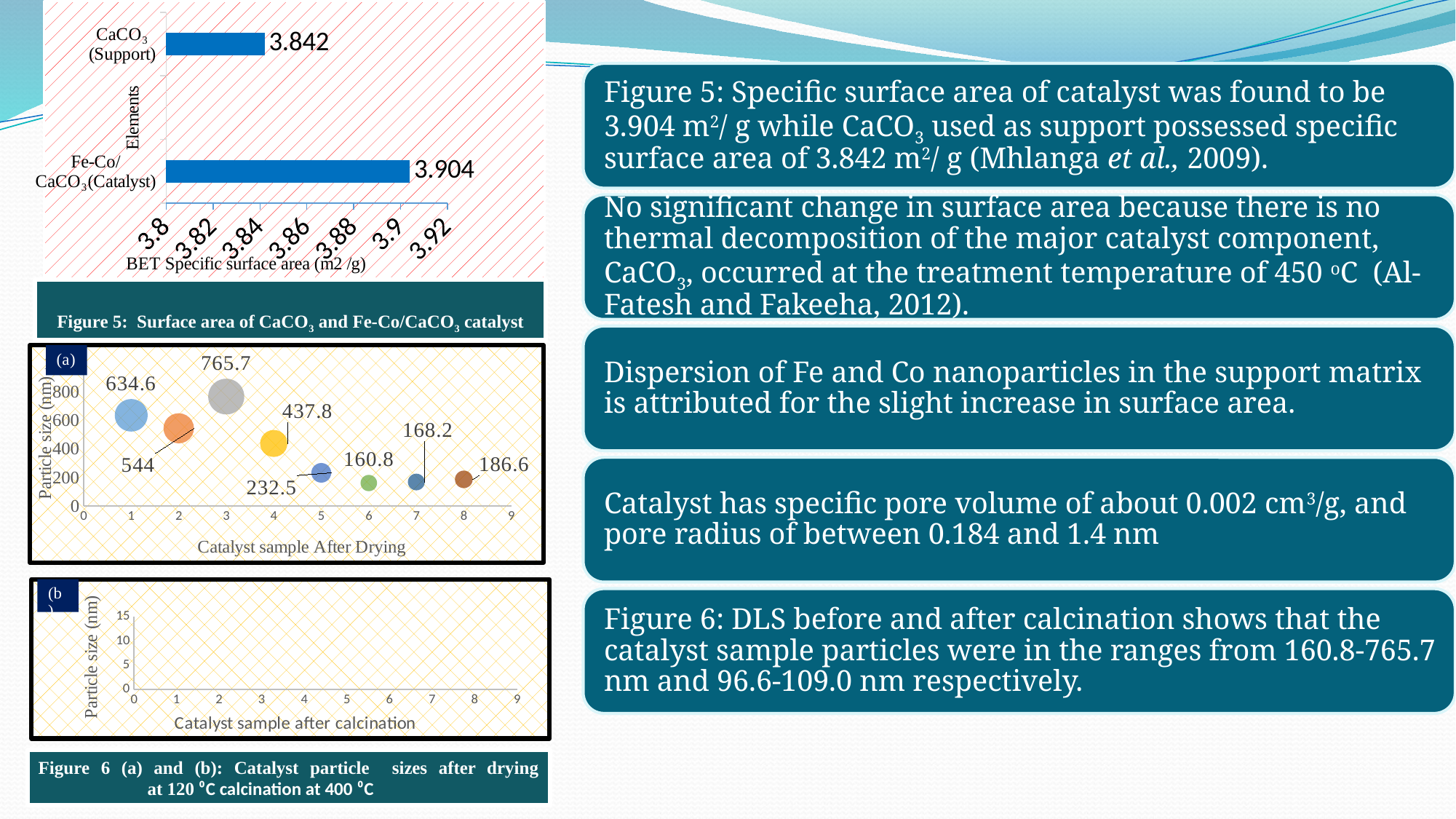
In the bubble chart in Figure 6 (a), what is the difference in particle size between sample 1 (634.6) and sample 2 (544)? 90.6 In the bubble chart in Figure 6 (a), what is the particle size of catalyst sample 6? 160.8 In the bar chart in Figure 5, which element has the higher BET specific surface area? Fe-Co/CaCO3 (Catalyst) In the bar chart in Figure 5, how many categories are plotted? 2 In the bubble chart in Figure 6 (a), what is the particle size of catalyst sample 3? 765.7 What kind of chart is Figure 5? Bar chart In the bubble chart in Figure 6 (a), which catalyst sample has the largest particle size? Sample 3 In the bubble chart in Figure 6 (a), which catalyst sample has the smallest particle size? Sample 6 In the bar chart in Figure 5, what is the difference between the surface area of Fe-Co/CaCO3 (Catalyst) and CaCO3 (Support)? 0.062 In the bubble chart in Figure 6 (a), how many catalyst samples are plotted? 8 In the bar chart in Figure 5, what is the BET specific surface area of the Fe-Co/CaCO3 (Catalyst)? 3.904 In the bar chart in Figure 5, what is the BET specific surface area of CaCO3 (Support)? 3.842